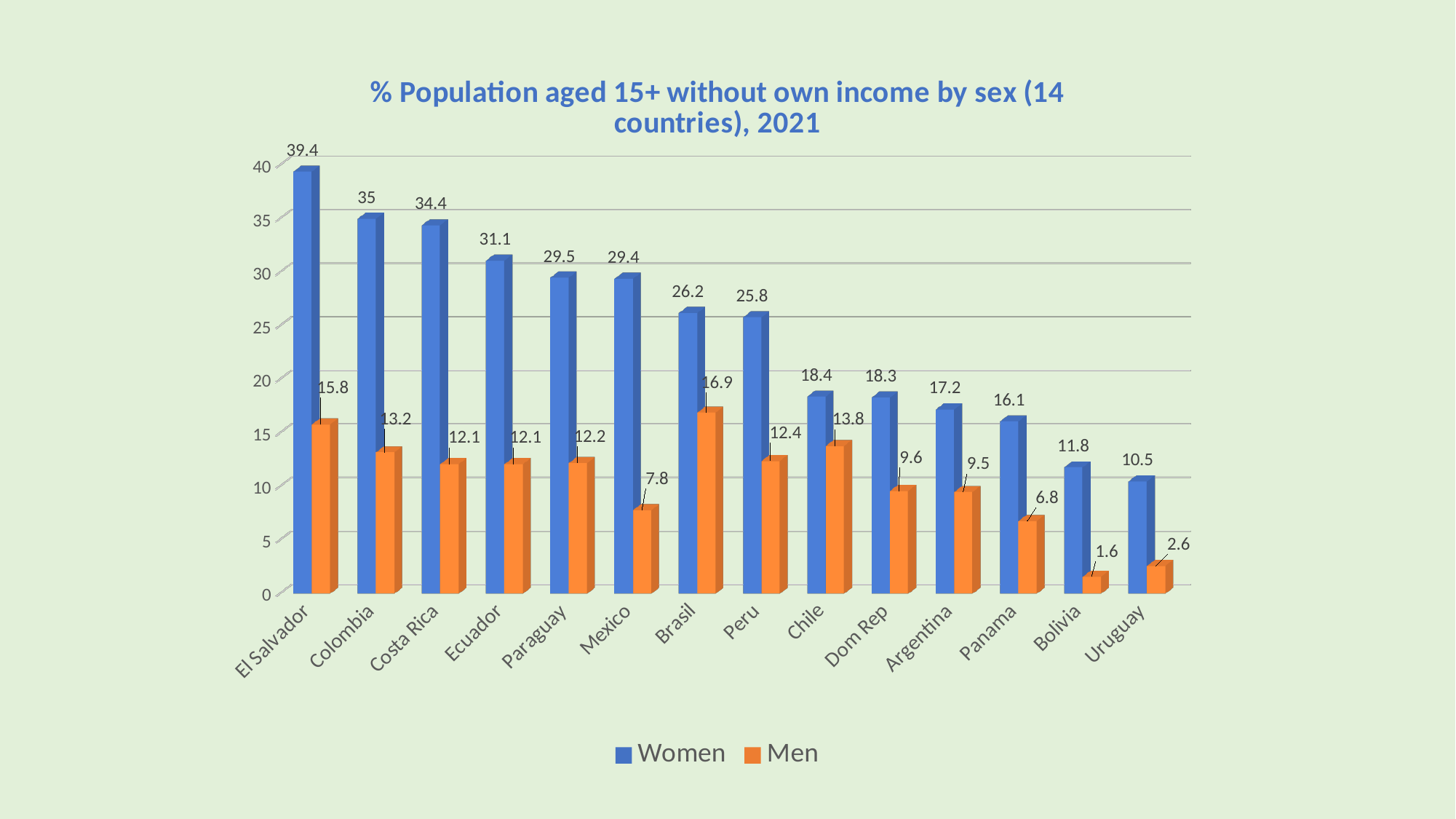
What is the value for Women in El Salvador? 39.4 How many countries are shown on the x axis? 14 How many series does the legend list? 2 Which is larger, the Men value for Colombia or the Men value for Chile? Chile Do the Women values rise or fall from left to right along the x axis? Fall What is the value for Men in Bolivia? 1.6 What is the difference between the Women and Men values for Mexico? 21.6 Is the value for Women in Peru greater or less than 25? greater Which country has the highest value for Women? El Salvador What is the value for Men in Brasil? 16.9 What kind of chart is shown? Bar chart Which country has the lowest value for Men? Bolivia